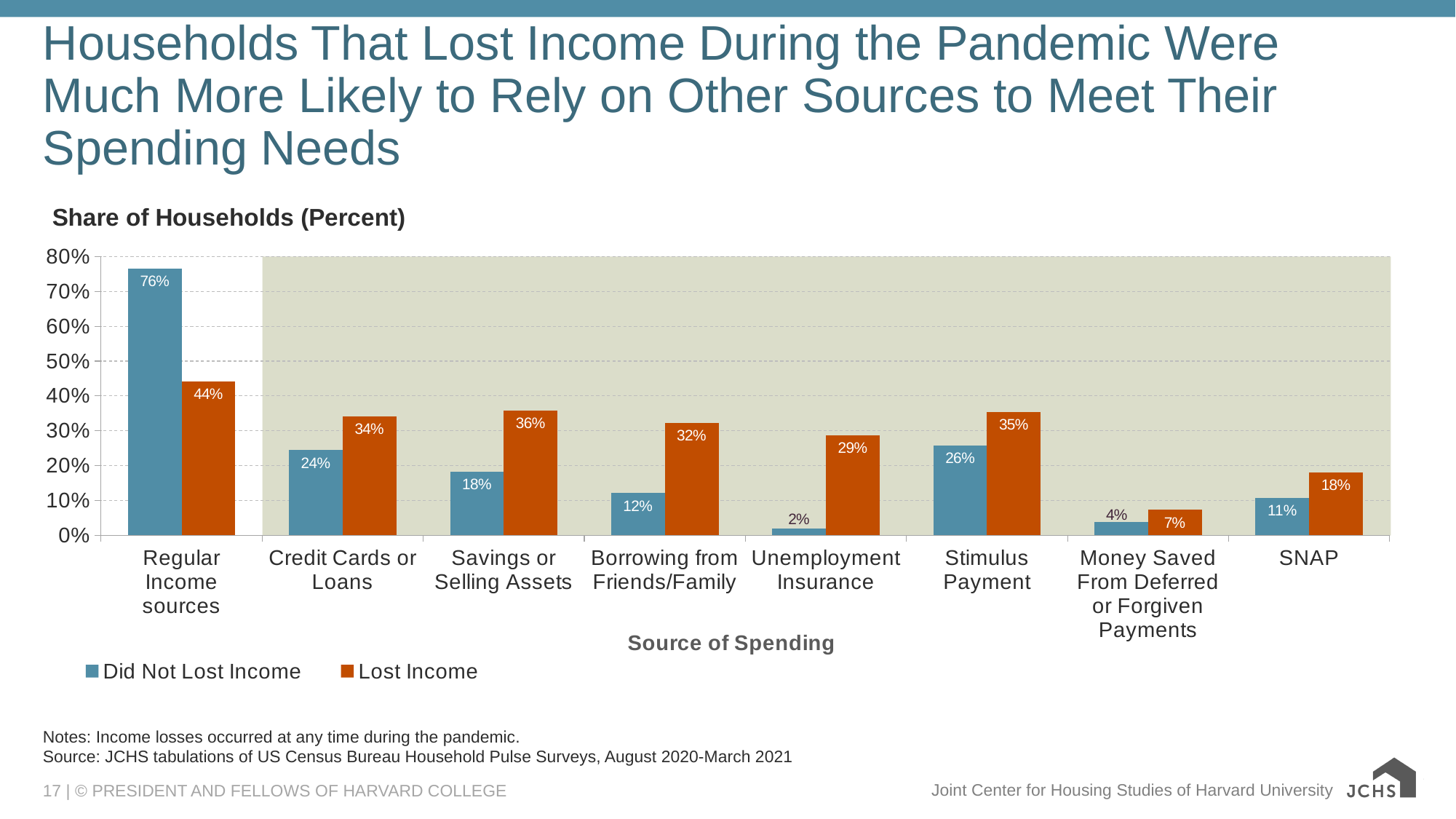
What is the difference between the Lost Income and Did Not Lost Income values for Credit Cards or Loans? 10% What is the value for Lost Income households for SNAP? 18% Which source of spending has the highest value for the Lost Income series? Regular Income sources Which source of spending has the lowest value for the Did Not Lost Income series? Unemployment Insurance For Stimulus Payment, which series has the larger value: Did Not Lost Income or Lost Income? Lost Income What kind of chart is shown on the slide? Bar chart How many series does the legend list? 2 What is the title of the x axis? Source of Spending Is the Lost Income value for Savings or Selling Assets greater or less than 30%? greater What is the value for Did Not Lost Income households for Regular Income sources? 76% How many sources of spending are shown on the x axis? 8 What is the value for Lost Income households for Unemployment Insurance? 29%